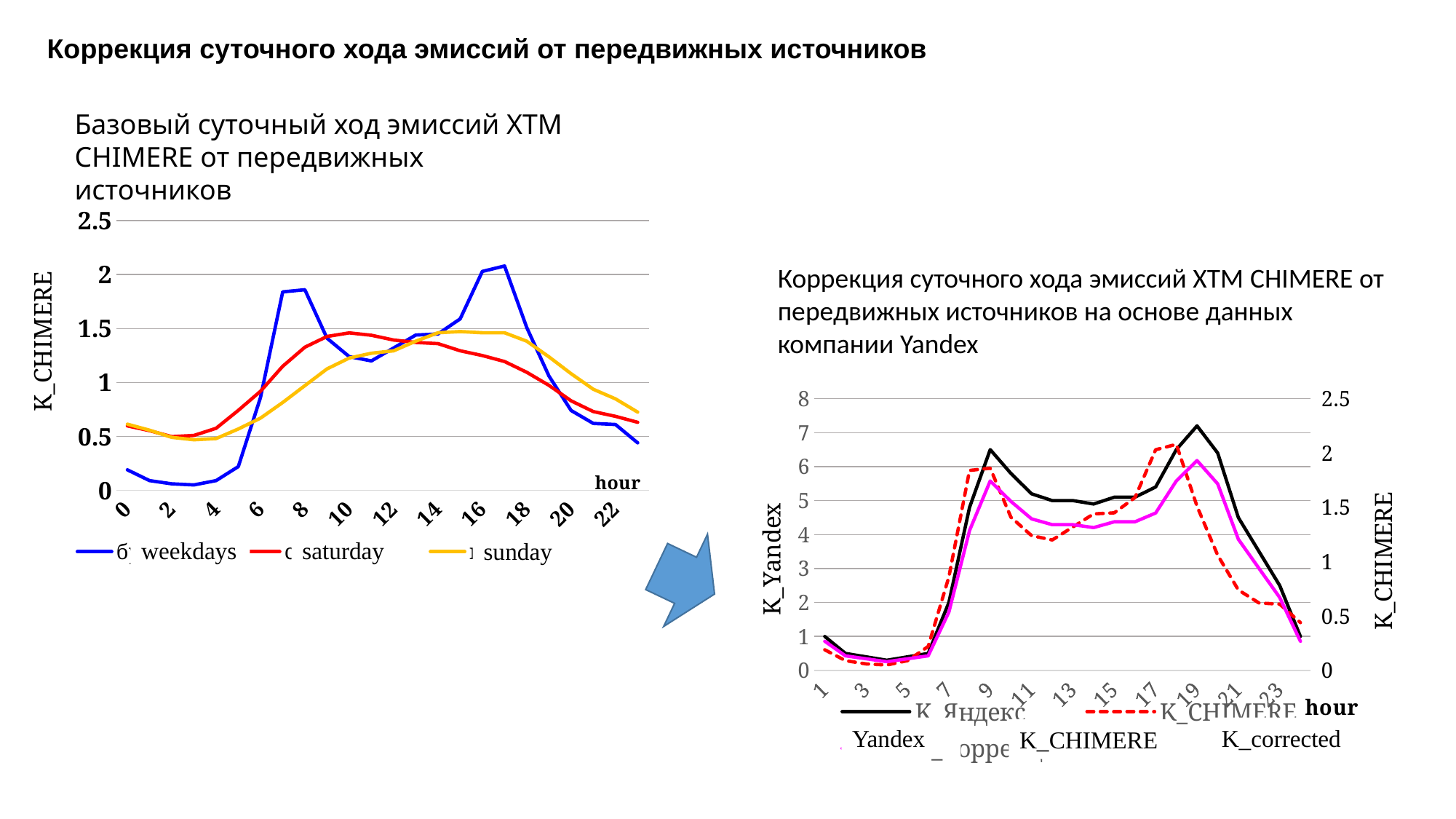
In the left chart, at hour 10, which is larger: saturday or weekdays? saturday In the left chart, which series reaches the highest peak value? weekdays In the right chart, which series is drawn with a dashed line? K_CHIMERE How many series does the legend of the right chart (correction based on Yandex data) list? 3 What kind of chart is the left chart, 'Базовый суточный ход эмиссий XTM CHIMERE от передвижных источников'? line chart In the left chart, is the sunday value at hour 2 greater or less than 1? less In the right chart, is the Yandex value at hour 19 greater or less than 6? greater In the left chart, at hour 8, which is larger: weekdays or saturday? weekdays In the left chart, is the weekdays value at hour 7 greater or less than 1.5? greater How many series does the legend of the left chart list? 3 In the left chart, does the weekdays series rise or fall between hour 0 and hour 7? rise